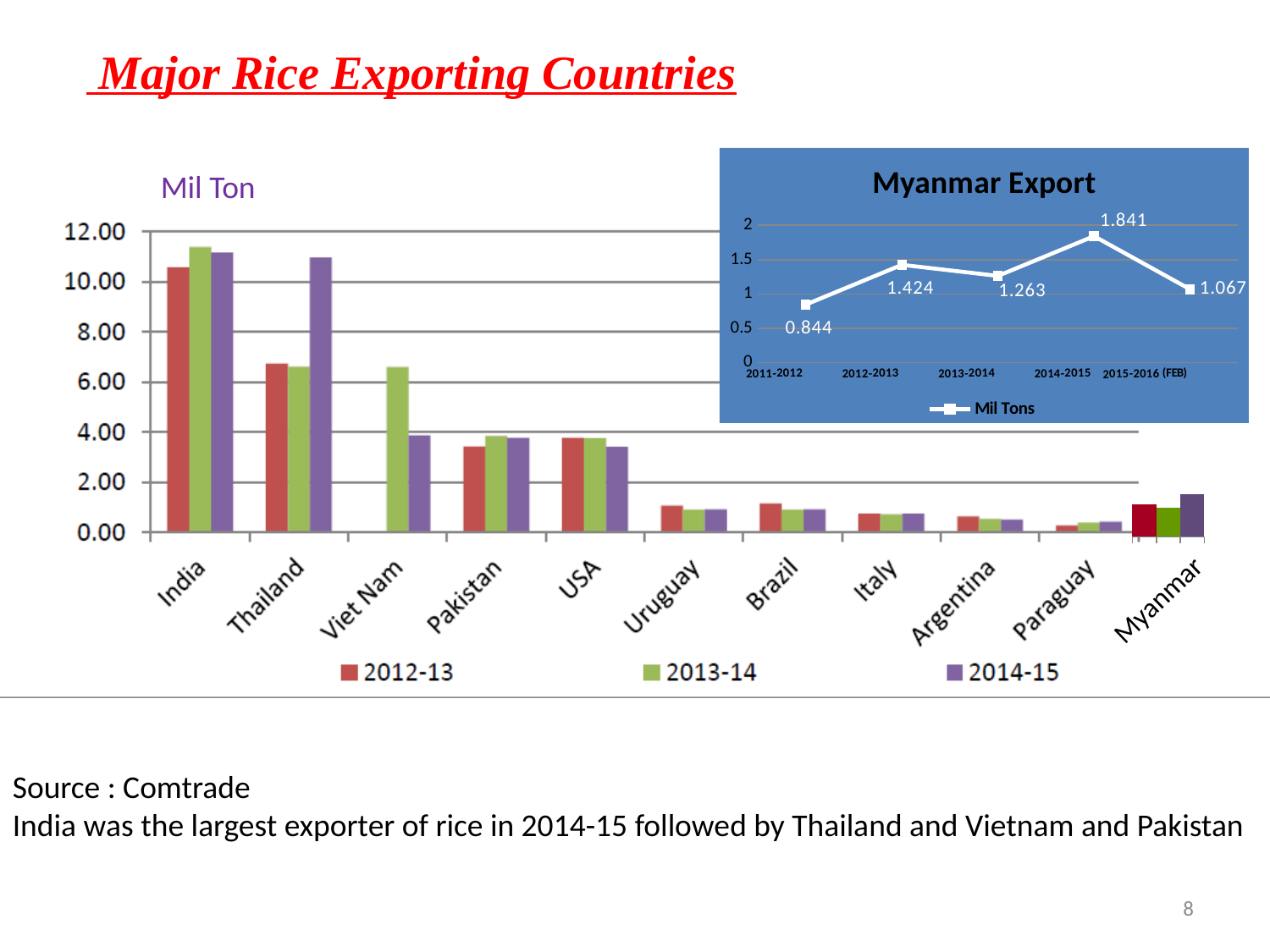
In the Major Rice Exporting Countries bar chart, which country has the highest 2014-15 value? India In the Myanmar Export chart, which period has the highest value? 2014-2015 What kind of chart is the Myanmar Export chart? Line chart In the Myanmar Export chart, how many data points are plotted? 5 In the Myanmar Export chart, which period has the lowest value? 2011-2012 In the Major Rice Exporting Countries bar chart, is the 2014-15 value for India greater or less than 10.00? greater In the Major Rice Exporting Countries bar chart, how many countries are shown on the x axis? 11 In the Myanmar Export chart, what is the difference between the 2014-2015 value and the 2015-2016 (FEB) value? 0.774 In the Myanmar Export chart, what is the value for 2011-2012? 0.844 In the Major Rice Exporting Countries bar chart, which is larger for 2013-14: Viet Nam or Pakistan? Viet Nam In the Major Rice Exporting Countries bar chart, how many series does the legend list? 3 In the Myanmar Export chart, what is the value for 2014-2015? 1.841